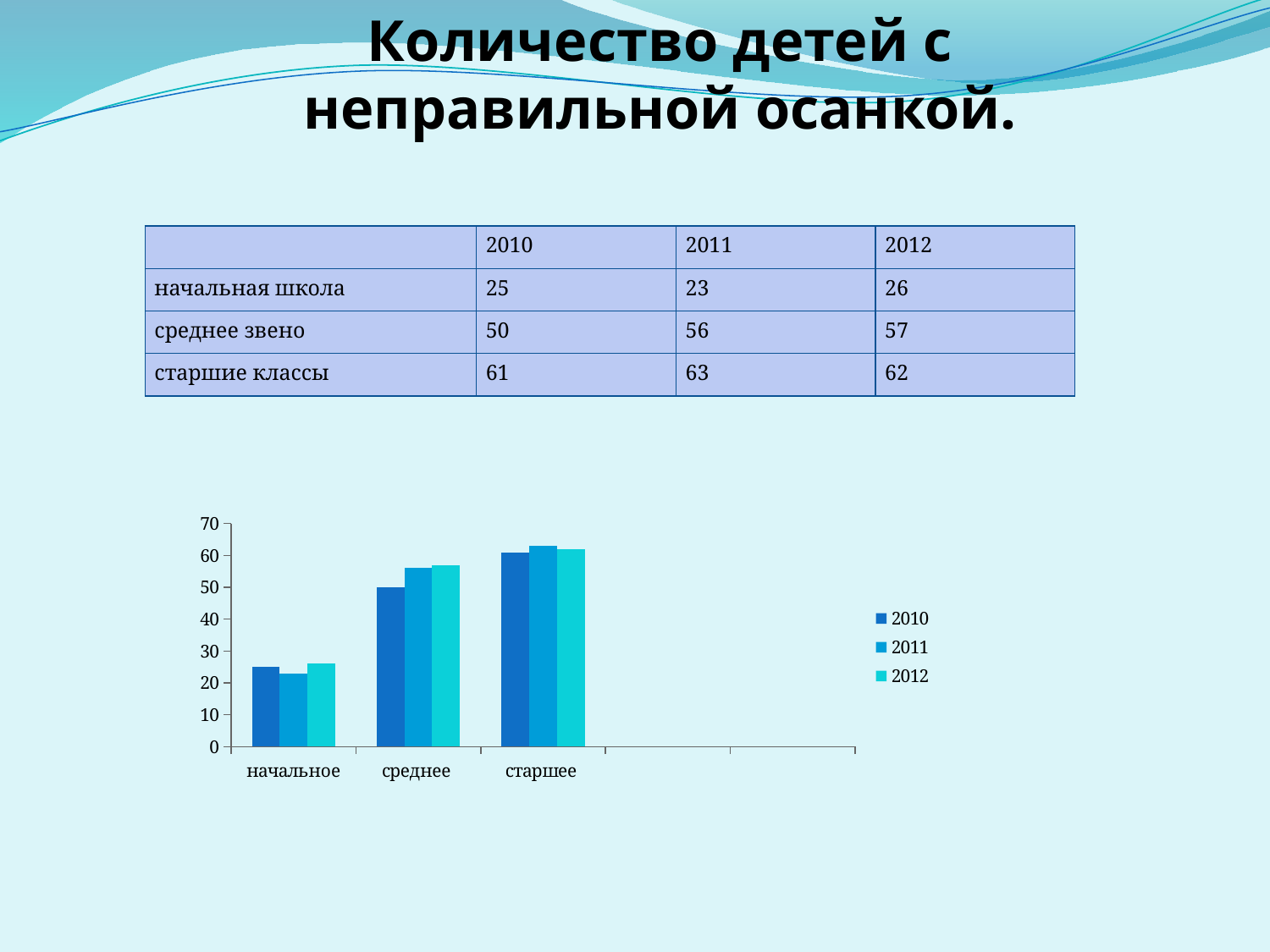
What is the difference between the 2012 and 2010 values for среднее звено shown on the slide? 7 Is the 2011 value for начальное greater or less than 30? less According to the slide, what is the value for старшие классы in 2010? 61 According to the slide, what is the value for среднее звено in 2011? 56 What kind of chart is shown on the slide? bar chart Which category has the highest bars in the chart? старшее Is the 2012 value for старшее greater or less than 50? greater How many categories are shown on the x axis of the chart? 3 How many series does the chart legend list? 3 Is the 2010 value for среднее greater or less than 40? greater Which category has the lowest bars in the chart? начальное Which is larger: the 2010 value for среднее or the 2010 value for начальное? среднее